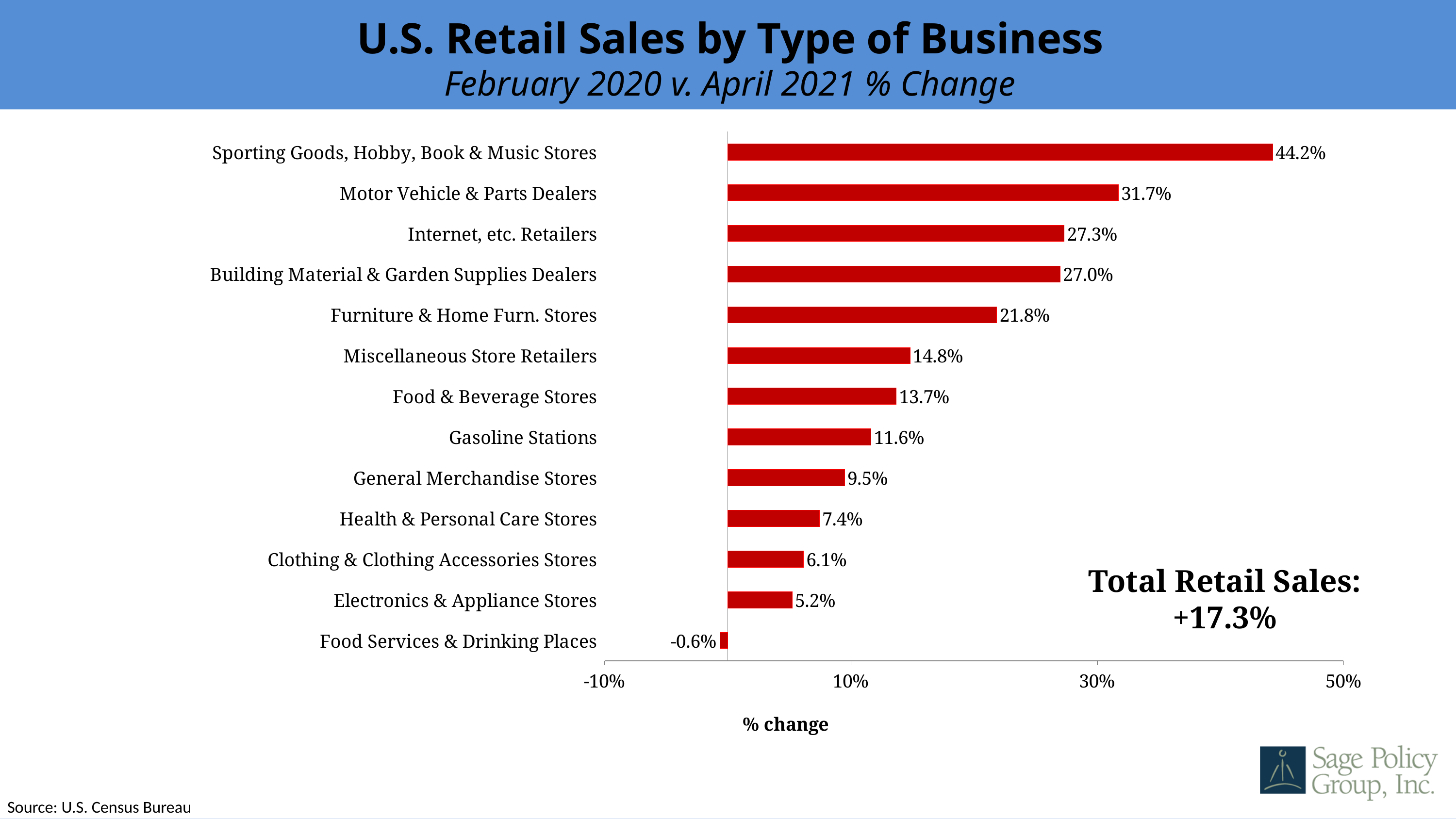
Is the value for General Merchandise Stores greater or less than 10%? less How many types of business are shown in the chart? 13 Which has a larger % change, Furniture & Home Furn. Stores or Miscellaneous Store Retailers? Furniture & Home Furn. Stores Which type of business has the lowest % change? Food Services & Drinking Places What is the difference in % change between Sporting Goods, Hobby, Book & Music Stores and Motor Vehicle & Parts Dealers? 12.5% What is the % change for Gasoline Stations? 11.6% What is the % change for Food Services & Drinking Places? -0.6% What is the % change for Motor Vehicle & Parts Dealers? 31.7% What kind of chart is shown on the slide? Bar chart Which type of business has the highest % change? Sporting Goods, Hobby, Book & Music Stores What is the total retail sales % change stated on the slide? +17.3% What is the difference in % change between Internet, etc. Retailers and Building Material & Garden Supplies Dealers? 0.3%